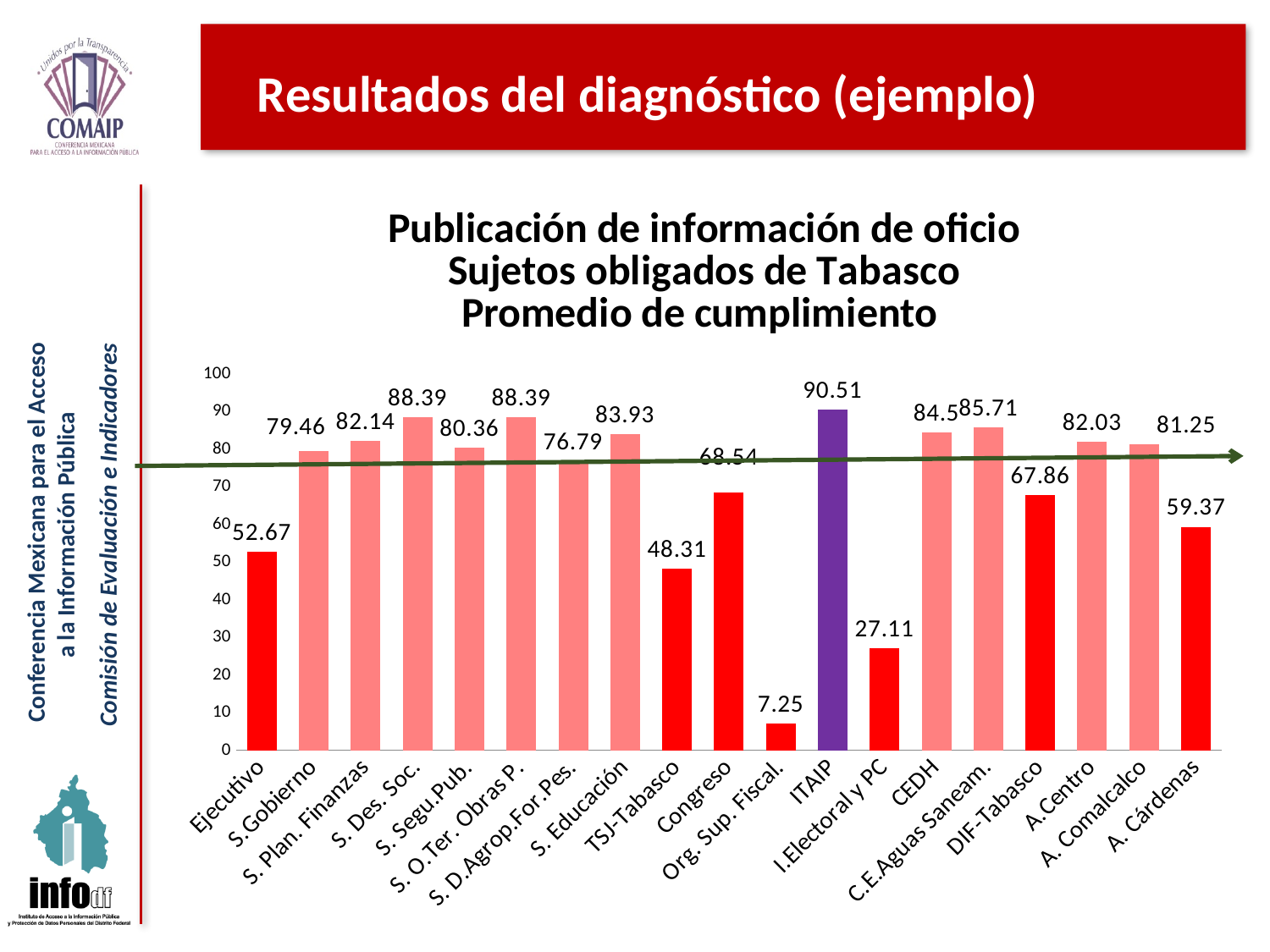
Which category's bar is coloured purple? ITAIP What is the difference between the values for ITAIP and Org. Sup. Fiscal.? 83.26 What is the value for Org. Sup. Fiscal.? 7.25 What is the value for Ejecutivo? 52.67 What is the value for ITAIP? 90.51 How many categories are shown on the x axis? 19 Which category has the lowest value? Org. Sup. Fiscal. What is the value for A. Cárdenas? 59.37 Which category has the highest value? ITAIP Which is larger, the value for TSJ-Tabasco or the value for I.Electoral y PC? TSJ-Tabasco What is the difference between the values for Congreso and DIF-Tabasco? 0.68 What kind of chart is shown on the slide? Bar chart